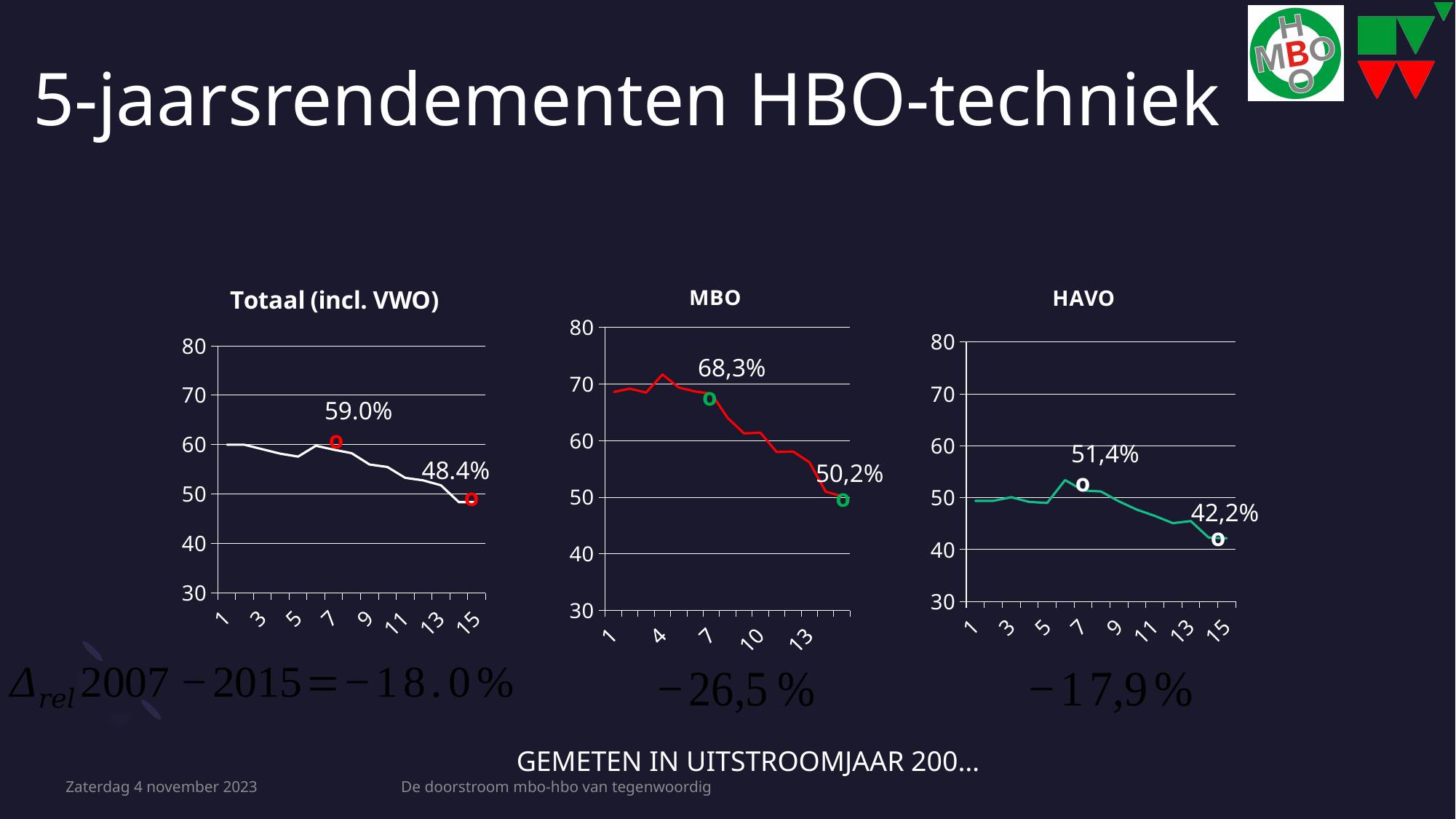
In the 'HAVO' chart, what is the difference between the labelled values at point 7 and point 15? 9,2 percentage points In the 'MBO' chart, what value is labelled at the last point of the line? 50,2% In the 'MBO' chart, what value is labelled at point 7? 68,3% In the 'Totaal (incl. VWO)' chart, what value is labelled at point 7? 59.0% What kind of chart is the 'HAVO' chart? line chart In the 'MBO' chart, is the value at point 4 greater or less than 70? greater In the 'Totaal (incl. VWO)' chart, what value is labelled at point 15? 48.4% In the 'Totaal (incl. VWO)' chart, what is the difference between the labelled values at point 7 and point 15? 10.6 percentage points In the 'HAVO' chart, what value is labelled at point 15? 42,2% At point 7, which is larger: the labelled value in the 'MBO' chart or the labelled value in the 'HAVO' chart? MBO In the 'HAVO' chart, is the value at point 13 greater or less than 50? less In the 'MBO' chart, do the values generally rise or fall from left to right along the x axis? fall